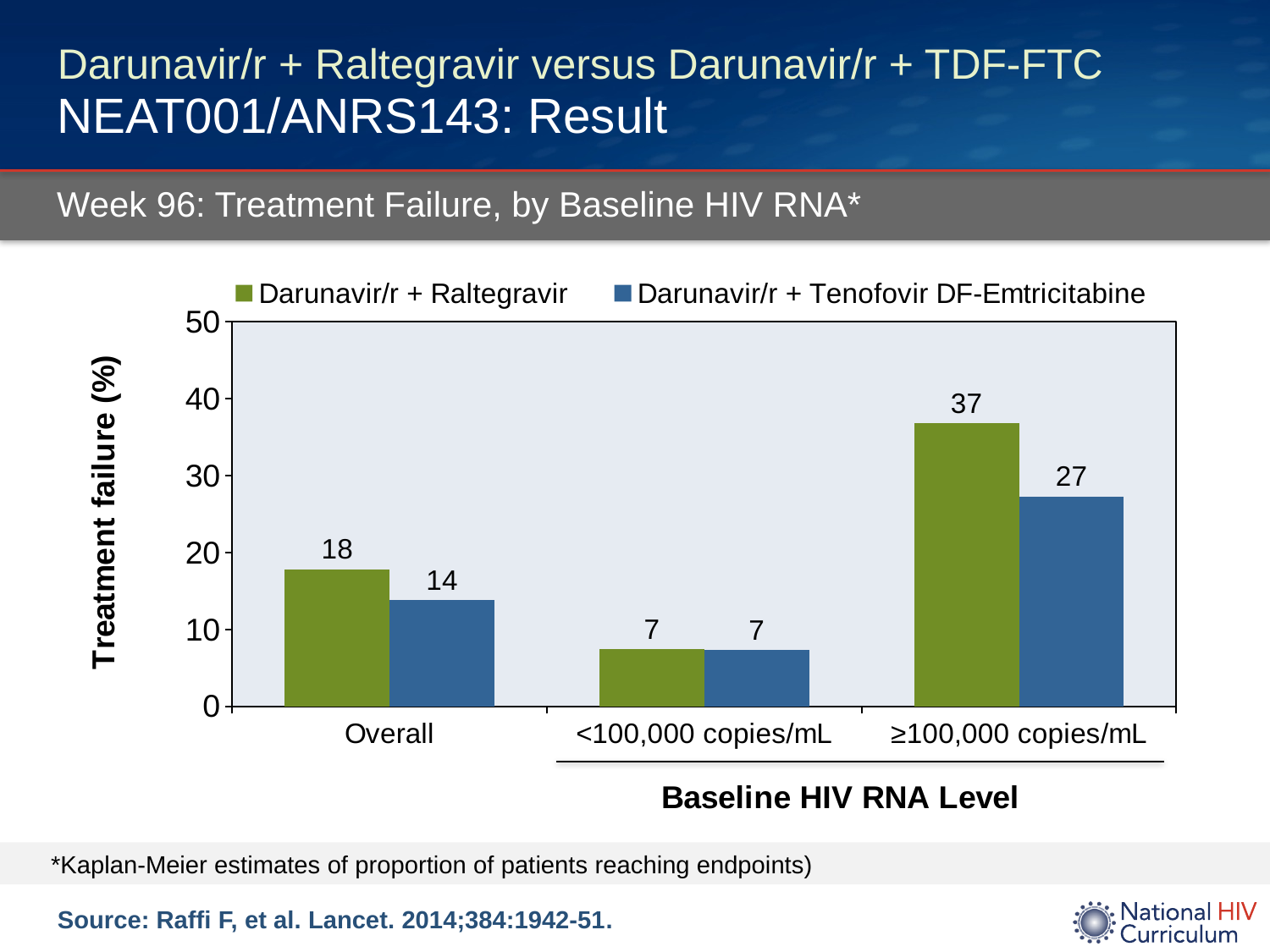
How many series does the legend list? 2 What kind of chart is shown on the slide? Bar chart In the Overall category, which series has the larger treatment failure value? Darunavir/r + Raltegravir What is the difference between the Darunavir/r + Raltegravir and Darunavir/r + Tenofovir DF-Emtricitabine values in the ≥100,000 copies/mL category? 10 Which category has the highest treatment failure value for Darunavir/r + Raltegravir? ≥100,000 copies/mL What is the treatment failure value for Darunavir/r + Tenofovir DF-Emtricitabine in the ≥100,000 copies/mL category? 27 Is the value for Darunavir/r + Raltegravir in the ≥100,000 copies/mL category greater or less than 30? greater Which category has the lowest treatment failure value for Darunavir/r + Tenofovir DF-Emtricitabine? <100,000 copies/mL What is the difference between the Darunavir/r + Raltegravir and Darunavir/r + Tenofovir DF-Emtricitabine values in the Overall category? 4 How many categories are shown on the x axis? 3 What is the treatment failure value for Darunavir/r + Raltegravir in the Overall category? 18 What is the treatment failure value for Darunavir/r + Tenofovir DF-Emtricitabine in the <100,000 copies/mL category? 7